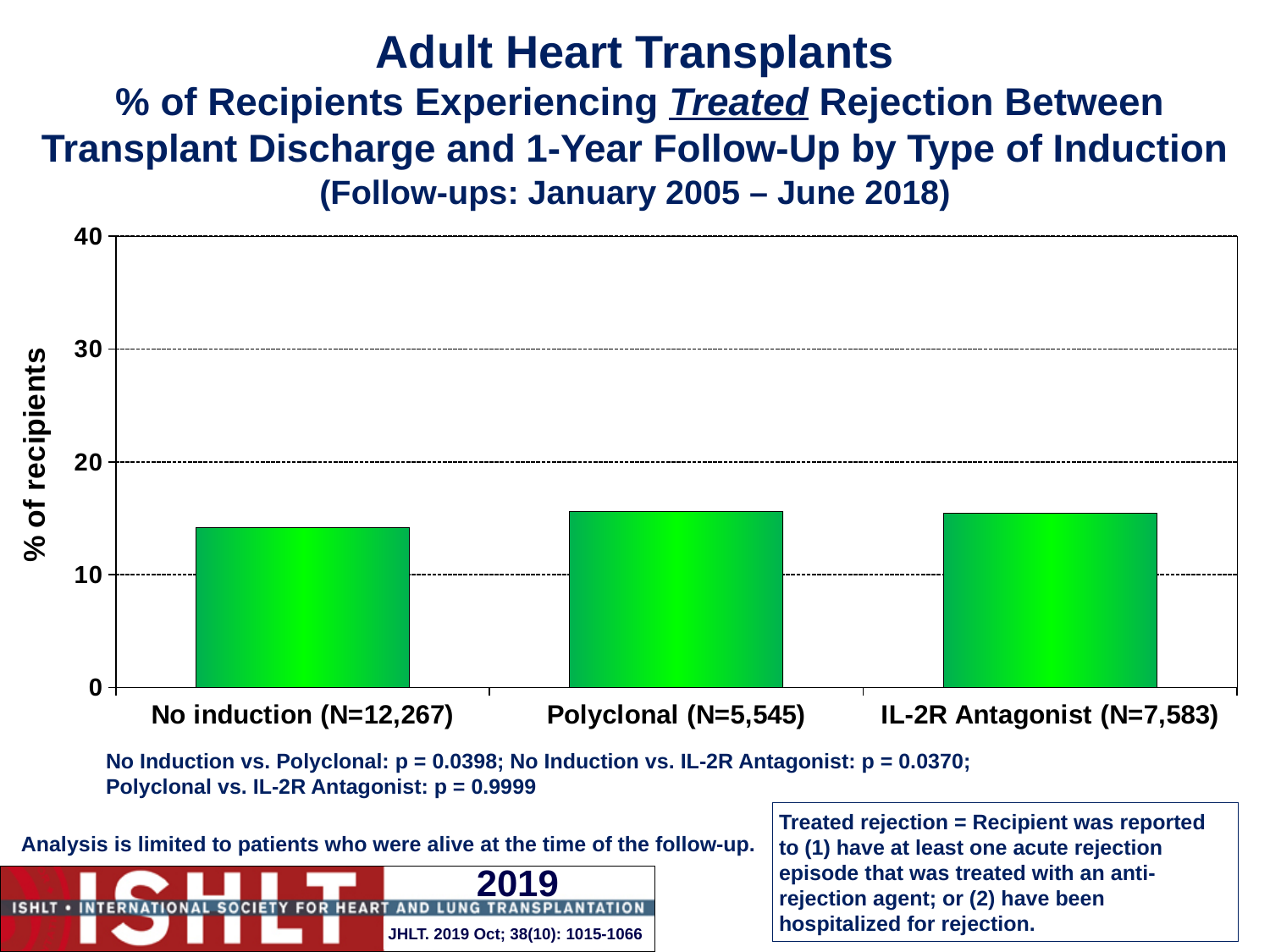
What is the label of the y axis? % of recipients Is the value for No induction (N=12,267) greater or less than 10? greater What kind of chart is shown on the slide? bar chart Which is larger, the value for No induction (N=12,267) or the value for IL-2R Antagonist (N=7,583)? IL-2R Antagonist (N=7,583) What is the maximum value shown on the y axis? 40 Is the value for IL-2R Antagonist (N=7,583) greater or less than 20? less Is the value for IL-2R Antagonist (N=7,583) greater or less than 10? greater How many induction-type categories are plotted on the chart? 3 Which induction type has the lowest % of recipients experiencing treated rejection? No induction (N=12,267) Which is larger, the value for No induction (N=12,267) or the value for Polyclonal (N=5,545)? Polyclonal (N=5,545)